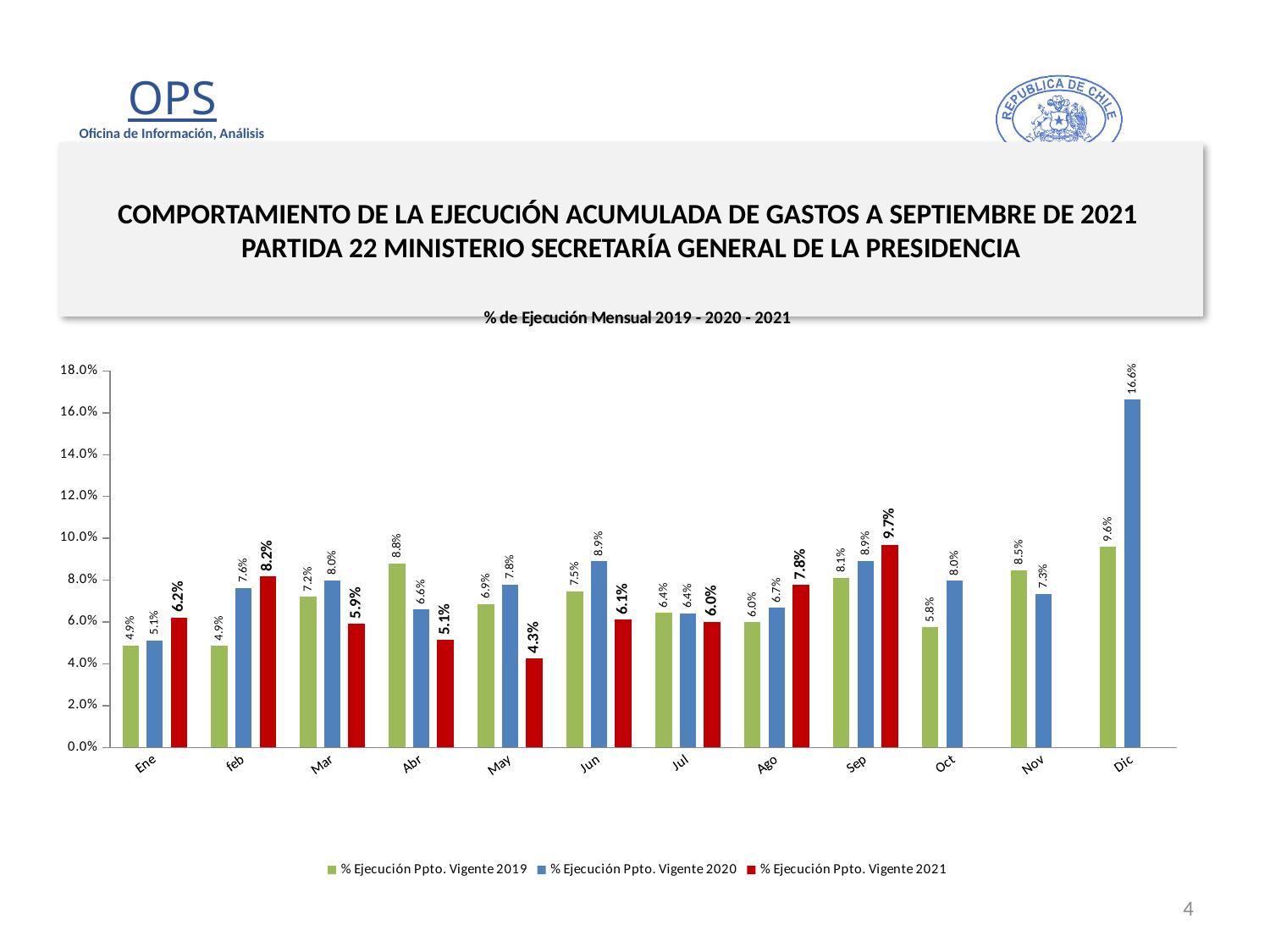
What is the value for Abr in the % Ejecución Ppto. Vigente 2019 series? 8.8% What is the value for Dic in the % Ejecución Ppto. Vigente 2020 series? 16.6% Is the value for Dic in the 2020 series greater or less than 14.0%? greater What colour represents the % Ejecución Ppto. Vigente 2021 series? Red What kind of chart is shown? Bar chart How many months are shown on the x axis? 12 How many series does the legend list? 3 What is the value for Sep in the % Ejecución Ppto. Vigente 2021 series? 9.7% Which is larger for Mar: the 2020 value or the 2021 value? 2020 value Which month has the highest value in the % Ejecución Ppto. Vigente 2020 series? Dic What is the difference between the 2021 and 2019 values for Sep? 1.6% Which month has the lowest value in the % Ejecución Ppto. Vigente 2021 series? May